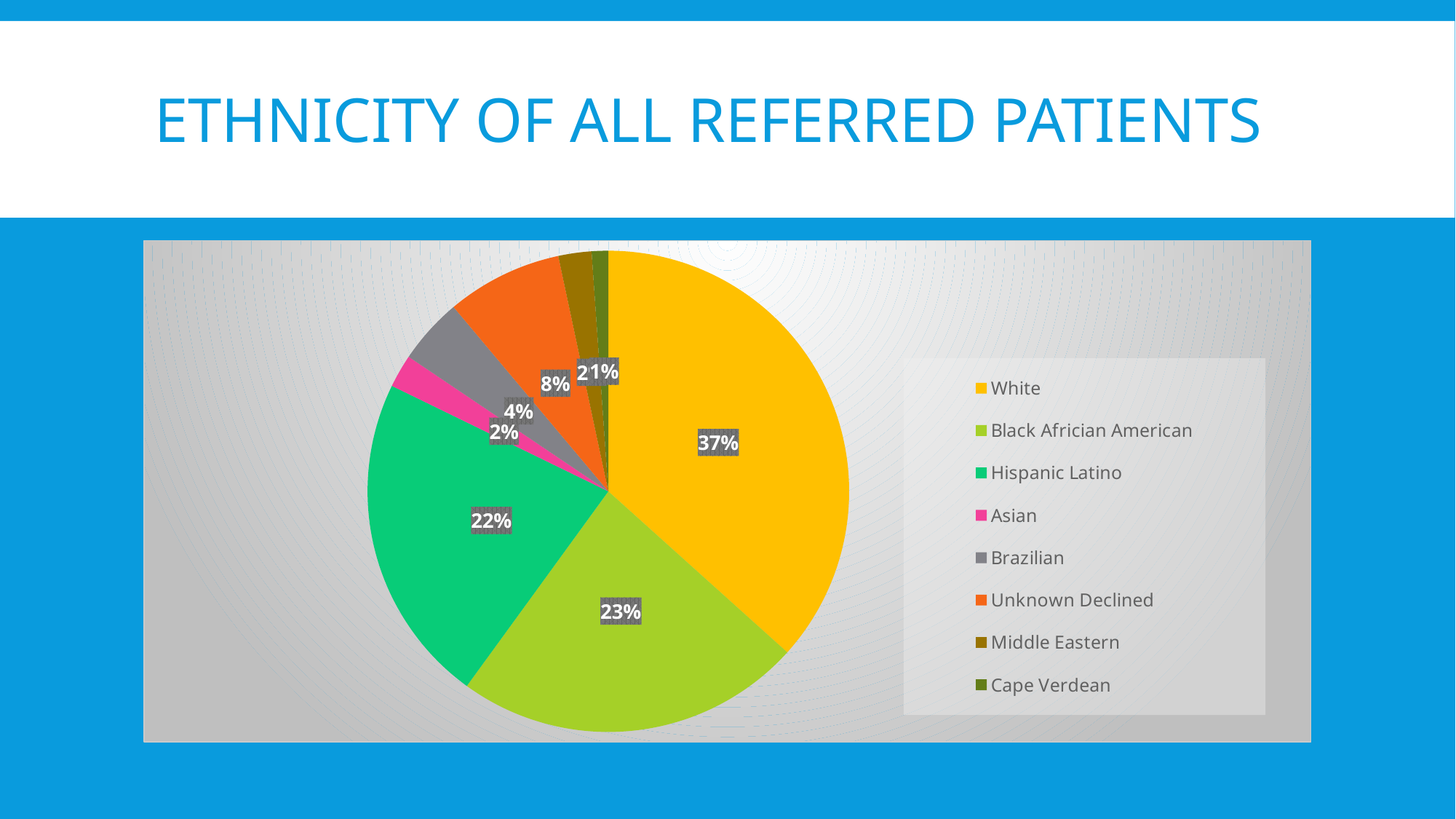
What share of referred patients is White? 37% What share of referred patients is Brazilian? 4% What share of referred patients is Black African American? 23% What share of referred patients is Hispanic Latino? 22% Which share is larger, Black African American or Hispanic Latino? Black African American What is the title of the chart? ETHNICITY OF ALL REFERRED PATIENTS How many categories does the legend list? 8 What is the difference in percentage points between the White and Black African American shares? 14% Which ethnicity has the largest share of the pie? White What share of referred patients is Unknown Declined? 8% What kind of chart is shown on the slide? Pie chart What share of referred patients is Asian? 2%